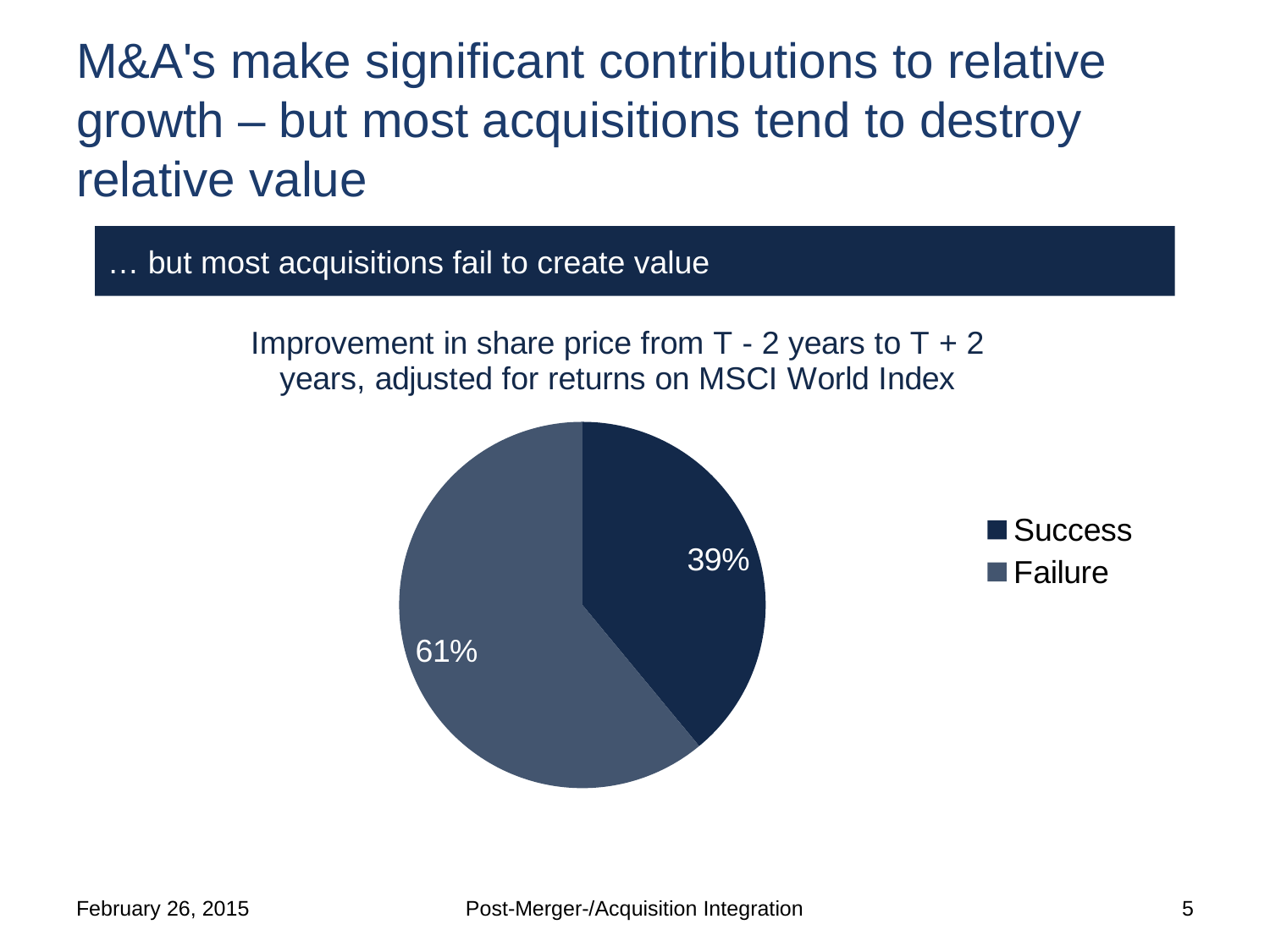
Which slice of the pie is the smallest? Success What is the difference in percentage points between the Failure slice and the Success slice? 22 Is the Success slice greater or less than 50% of the pie? less How many entries does the legend list? 2 Which is larger, the Success slice or the Failure slice? Failure Which legend entry is shown in the darker navy colour? Success What percentage of the pie is labelled Failure? 61% Which slice of the pie is the largest? Failure What kind of chart is shown on the slide? pie chart What percentage of the pie is labelled Success? 39% What is the title of the pie chart? Improvement in share price from T - 2 years to T + 2 years, adjusted for returns on MSCI World Index How many slices does the pie chart have? 2